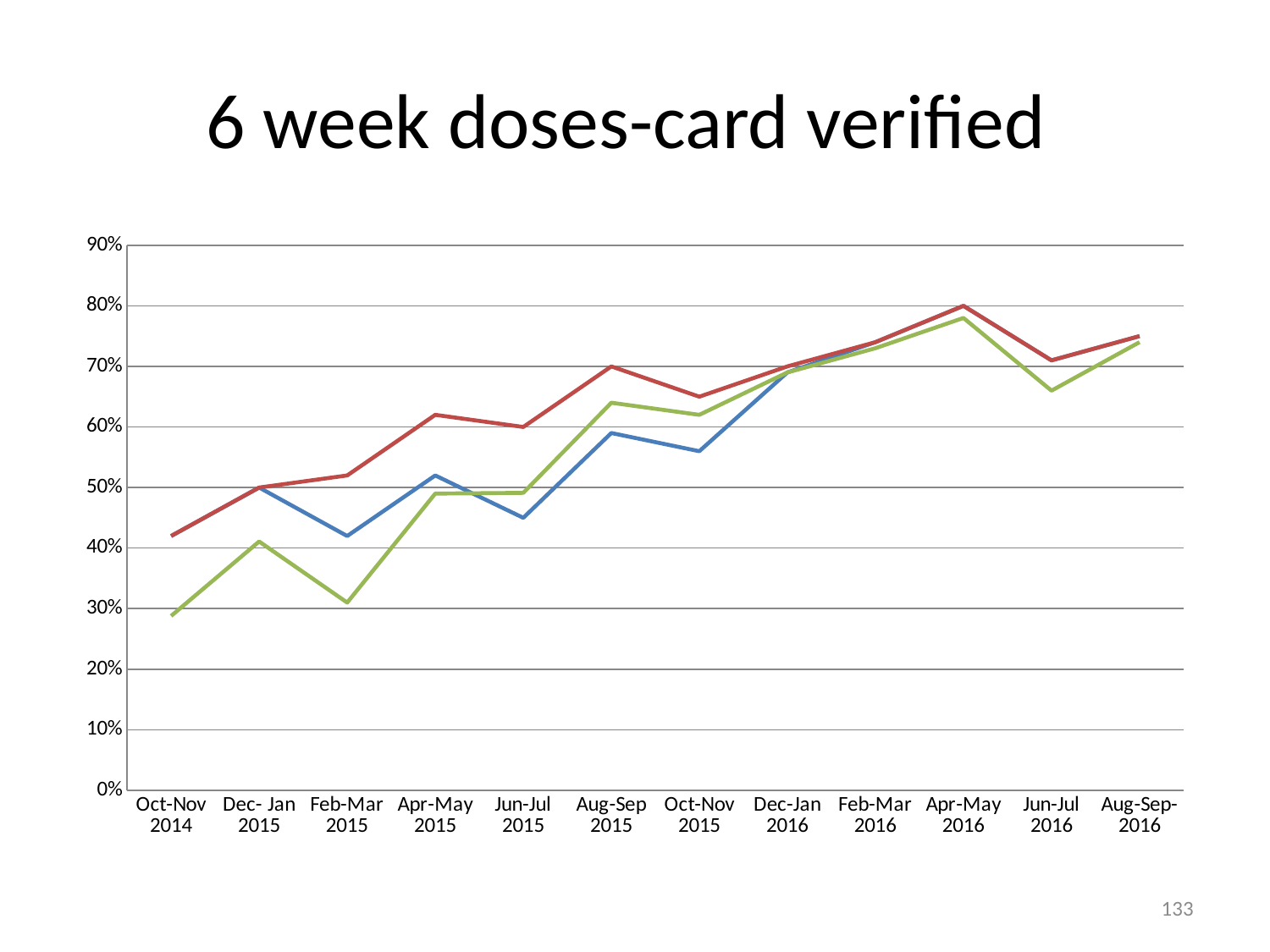
What kind of chart is shown on the slide? line chart How many periods are labelled along the x axis? 12 Is the value of the blue line for Oct-Nov 2015 greater or less than 50%? greater At Oct-Nov 2014, which line has the higher value, the red line or the green line? red line Is the value of the red line for Apr-May 2016 greater or less than 70%? greater How many lines are plotted on the chart? 3 What is the title of the chart? 6 week doses-card verified Is the value of the green line for Feb-Mar 2015 greater or less than 40%? less At which period does the red line reach its highest value? Apr-May 2016 Overall, does the red line rise or fall from Oct-Nov 2014 to Aug-Sep 2016? rise